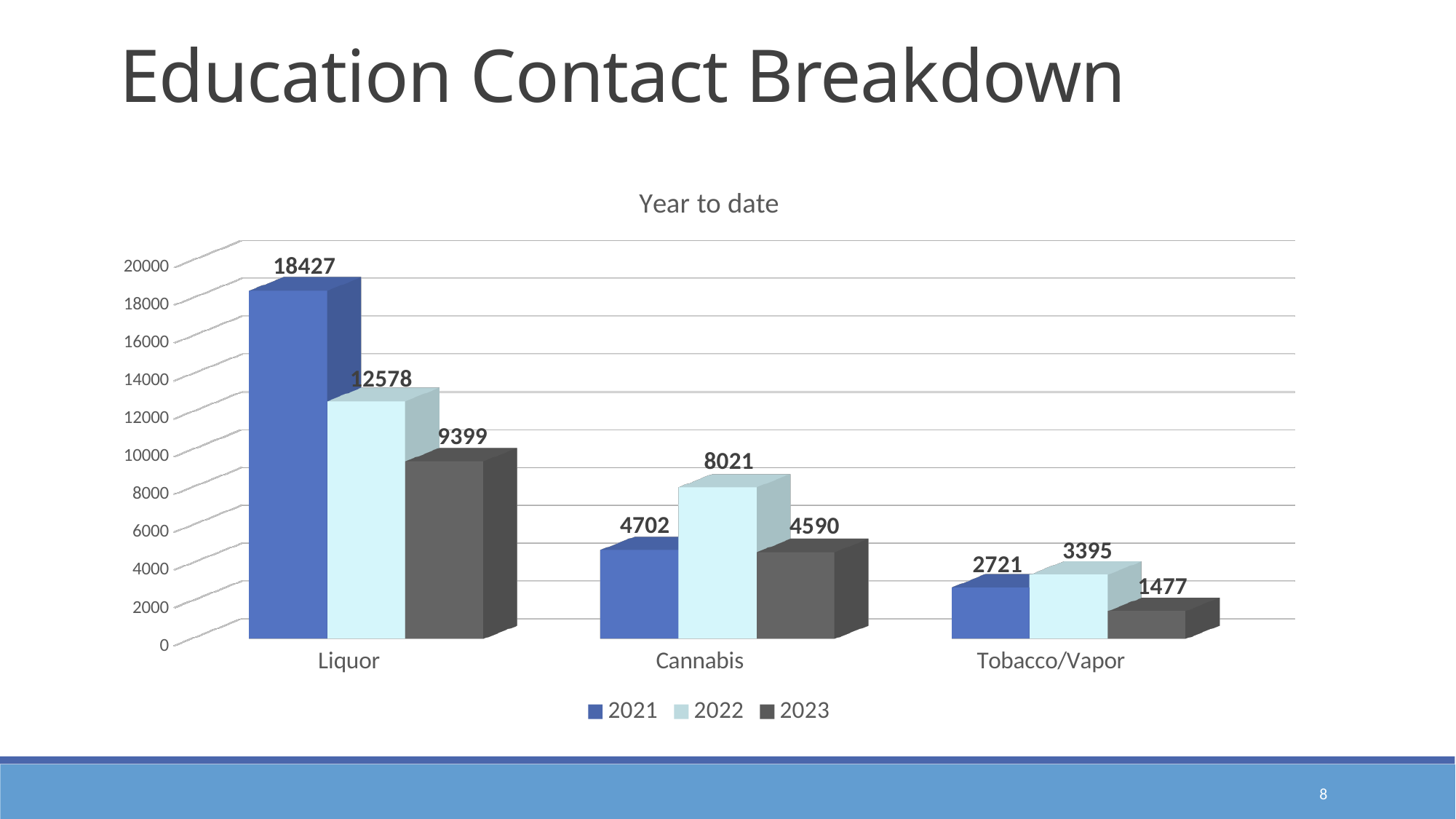
What is the value for Cannabis in 2022? 8021 What kind of chart is shown on the slide? Bar chart What is the value for Liquor in 2021? 18427 Do the 2022 values rise or fall from Liquor to Tobacco/Vapor along the x axis? Fall Which category has the highest value in 2021? Liquor How many categories are shown on the x axis? 3 What is the title of the chart? Year to date What is the value for Tobacco/Vapor in 2023? 1477 How many series does the legend list? 3 Which is larger for Cannabis: the 2021 value or the 2022 value? 2022 Which category has the lowest value in 2023? Tobacco/Vapor What is the difference between the 2021 and 2023 values for Liquor? 9028